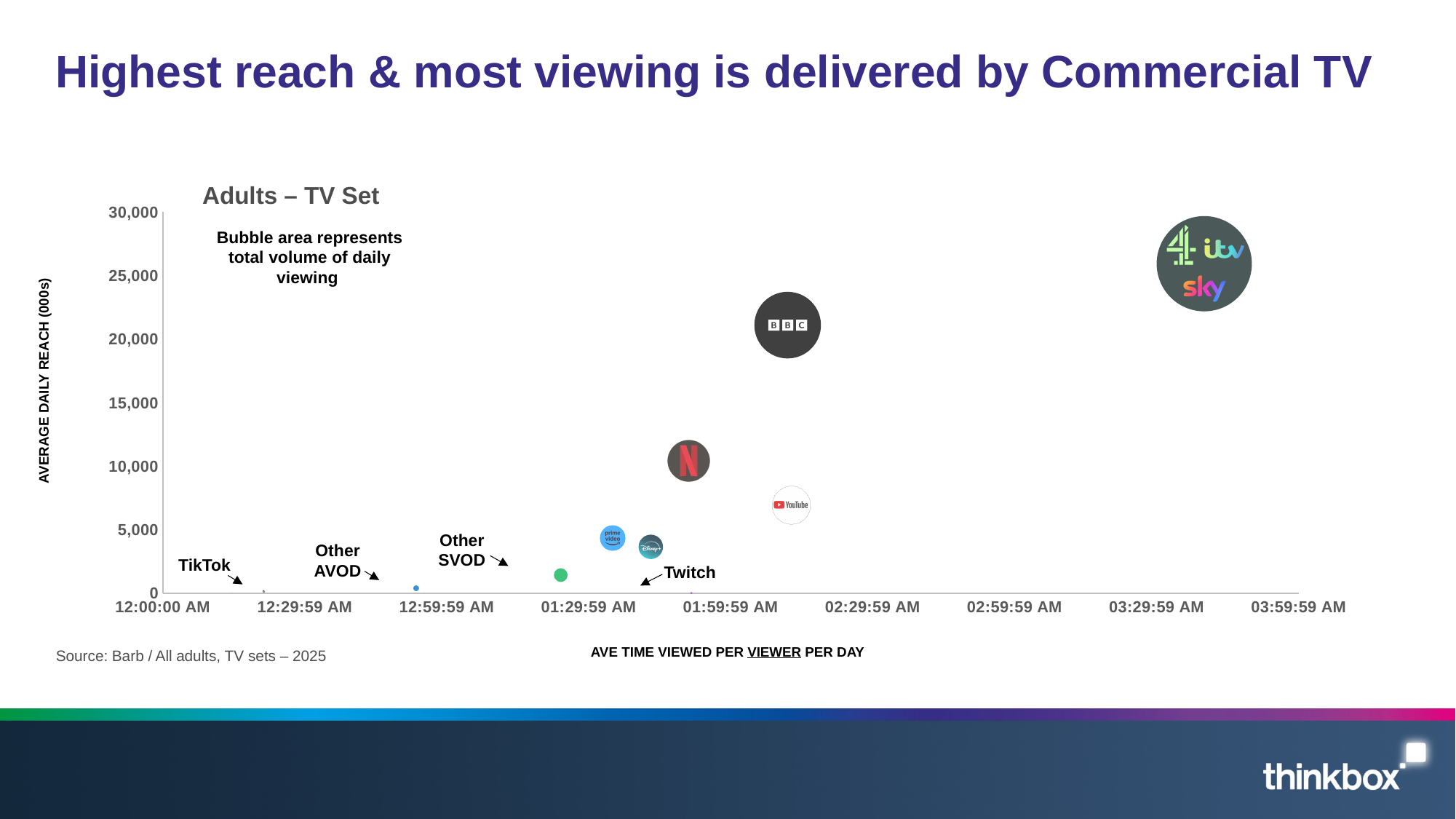
Which has the higher average daily reach, YouTube or Prime Video? YouTube Is the average daily reach for the BBC greater or less than 15,000? greater What is the title of the chart? Adults – TV Set Is the average daily reach for Netflix greater or less than 15,000? less According to the note on the chart, what does the bubble area represent? Total volume of daily viewing Is the average daily reach for the Commercial TV bubble (4 / itv / sky) greater or less than 20,000? greater Which has the higher average daily reach, the BBC or Netflix? BBC What kind of chart is shown on the slide? Bubble chart Which bubble has the highest average daily reach? Commercial TV (4 / itv / sky) Which has the longer average time viewed per viewer per day, Commercial TV (4 / itv / sky) or the BBC? Commercial TV (4 / itv / sky)